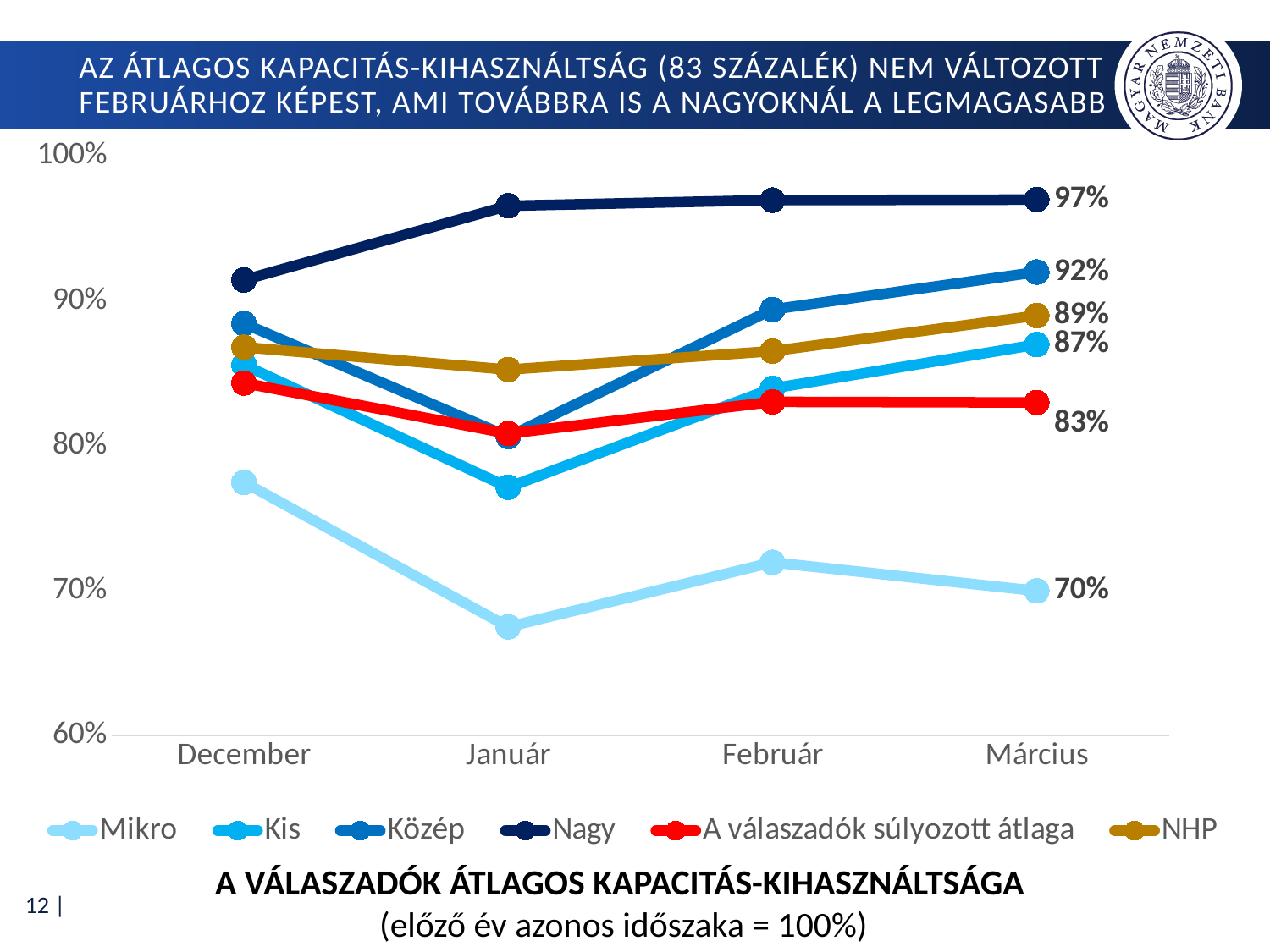
How many months are shown on the x axis? 4 What type of chart is shown on the slide? line chart What is the value for Mikro in Március? 70% What is the value for A válaszadók súlyozott átlaga in Március? 83% How many series does the legend list? 6 Does the Nagy series rise or fall from December to Január? rise What is the value for Nagy in Március? 97% Which series has the lowest value in Március? Mikro What is the value for NHP in Március? 89% Which series has the highest value in Március? Nagy What is the difference between the Nagy and Mikro values in Március? 27 percentage points Is the value for Mikro in Január greater or less than 70%? less